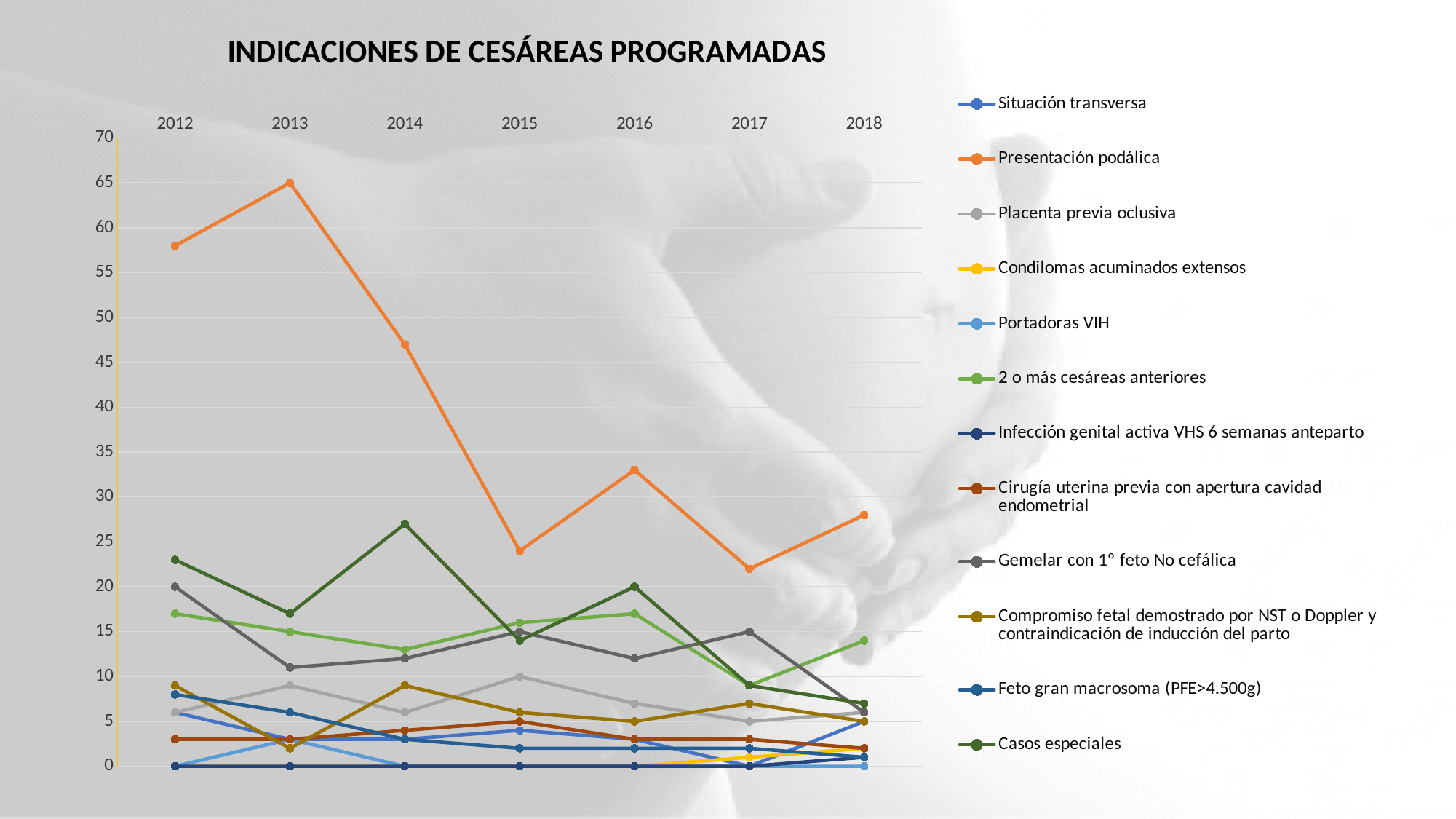
In which year does Presentación podálica reach its highest value? 2013 Is the value for Presentación podálica in 2017 greater or less than 25? less How many years are shown on the x axis? 7 What type of chart is shown on the slide? line chart What is the value for Presentación podálica in 2013? 65 Which is larger, Presentación podálica in 2012 or in 2018? 2012 What is the value for Gemelar con 1° feto No cefálica in 2012? 20 Does the Presentación podálica series overall rise or fall from 2012 to 2018? fall Which series has the highest value in 2013? Presentación podálica How many series does the legend list? 12 Is the value for Presentación podálica in 2016 greater or less than 30? greater What is the title of the chart? INDICACIONES DE CESÁREAS PROGRAMADAS